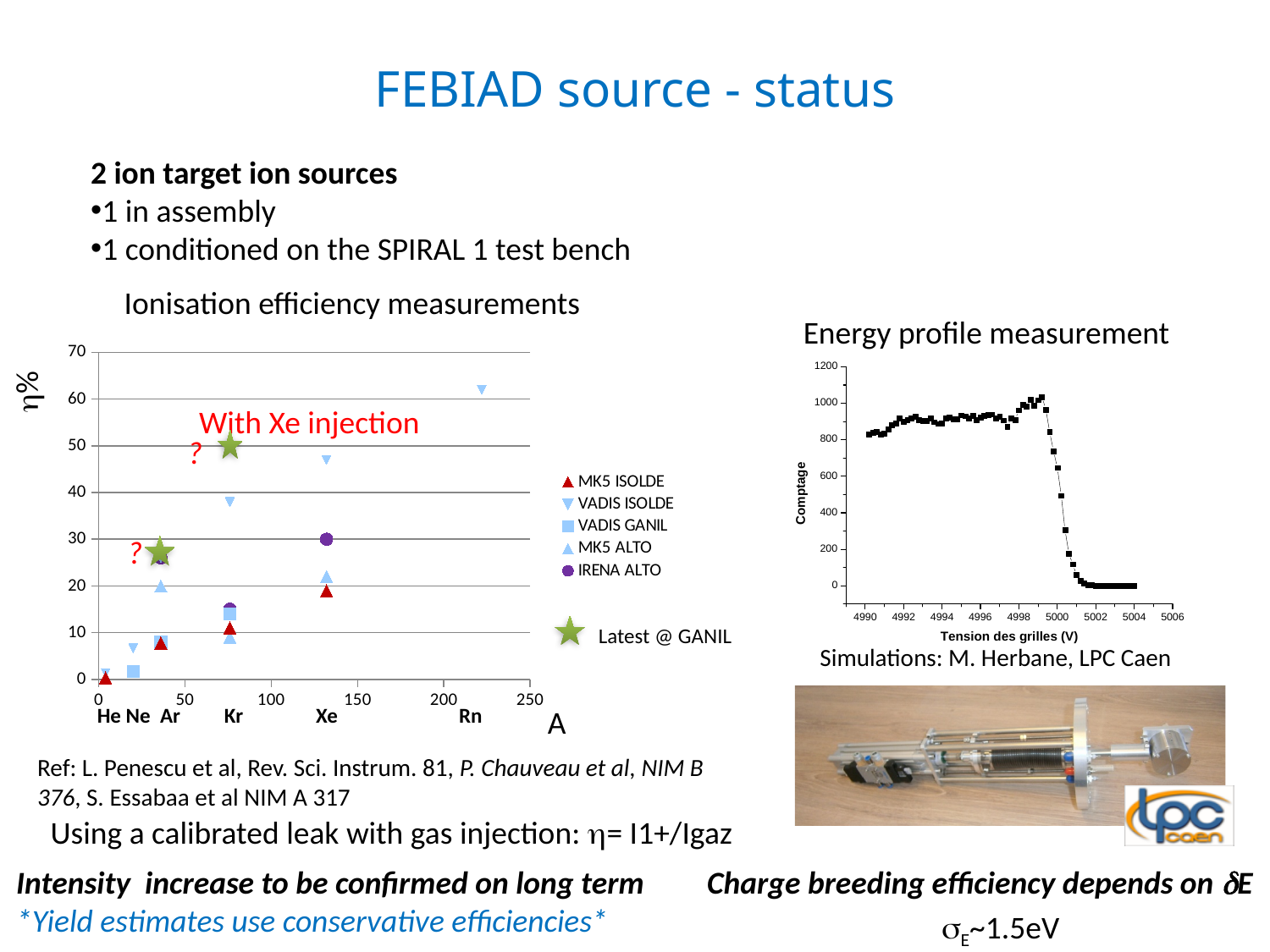
What kind of chart is the 'Ionisation efficiency measurements' chart? scatter chart On the 'Energy profile measurement' chart, does the Comptage rise or fall as the Tension des grilles increases past 5000 V? fall On the 'Ionisation efficiency measurements' chart, is the MK5 ALTO value at Ar greater or less than 10? greater On the 'Energy profile measurement' chart, what is the label of the x axis? Tension des grilles (V) How many series does the legend of the 'Ionisation efficiency measurements' chart list? 5 On the 'Energy profile measurement' chart, is the Comptage at 5004 V greater or less than 200? less On the 'Ionisation efficiency measurements' chart, is the MK5 ISOLDE value at He greater or less than 10? less On the 'Ionisation efficiency measurements' chart, what is the label of the y axis? η% On the 'Ionisation efficiency measurements' chart, which series has the highest plotted point? VADIS ISOLDE